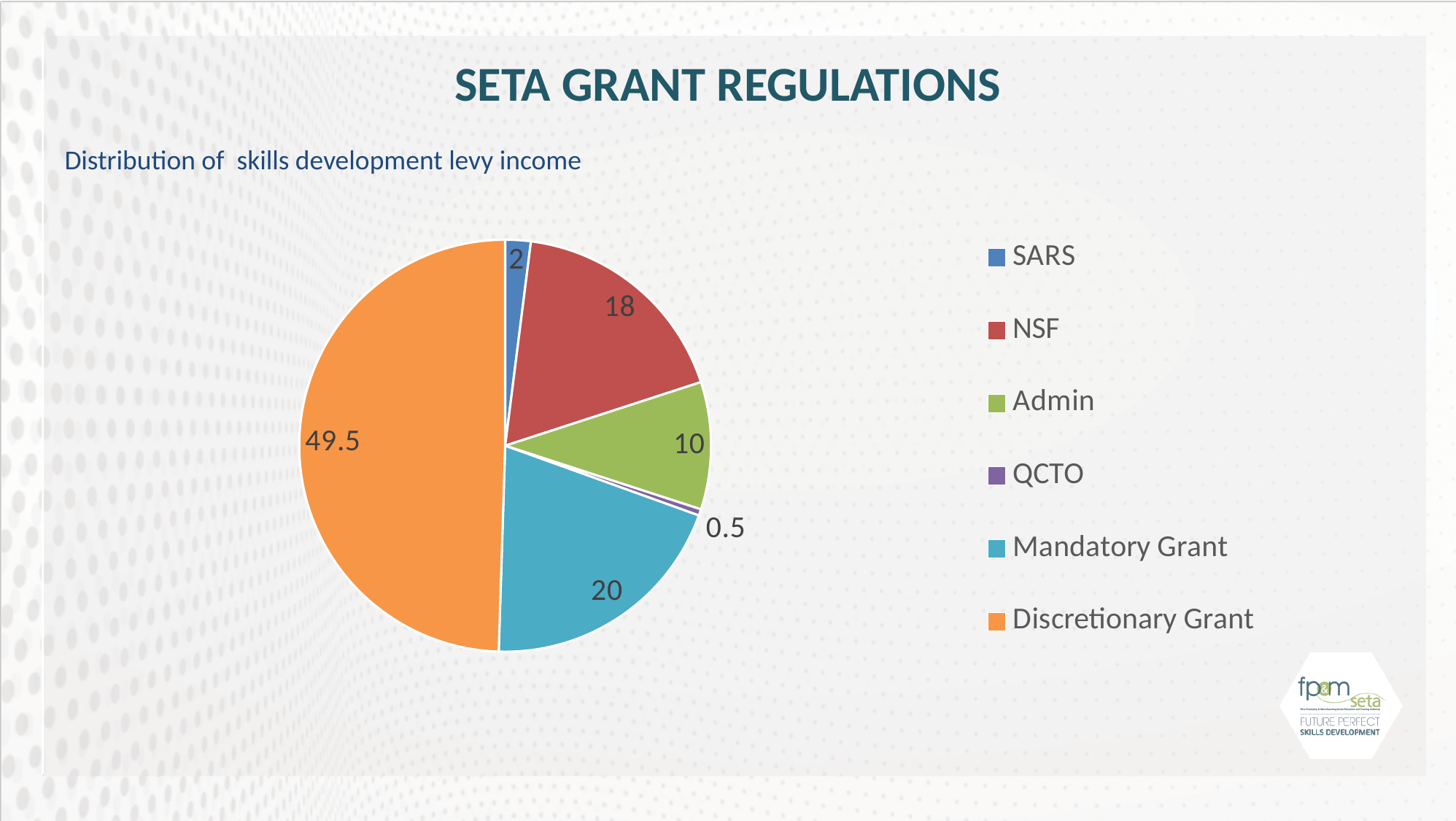
What is the difference between the values for Discretionary Grant and Mandatory Grant? 29.5 What is the value for Mandatory Grant? 20 What kind of chart is shown on the slide? pie chart What is the value for Discretionary Grant? 49.5 What is the subtitle describing the pie chart? Distribution of skills development levy income Which is larger, the value for NSF or the value for Admin? NSF What is the value for NSF? 18 What share of the pie does Admin represent? 10 Which category has the largest slice of the pie? Discretionary Grant Which category has the smallest slice of the pie? QCTO What is the value for QCTO? 0.5 How many categories does the pie chart show? 6